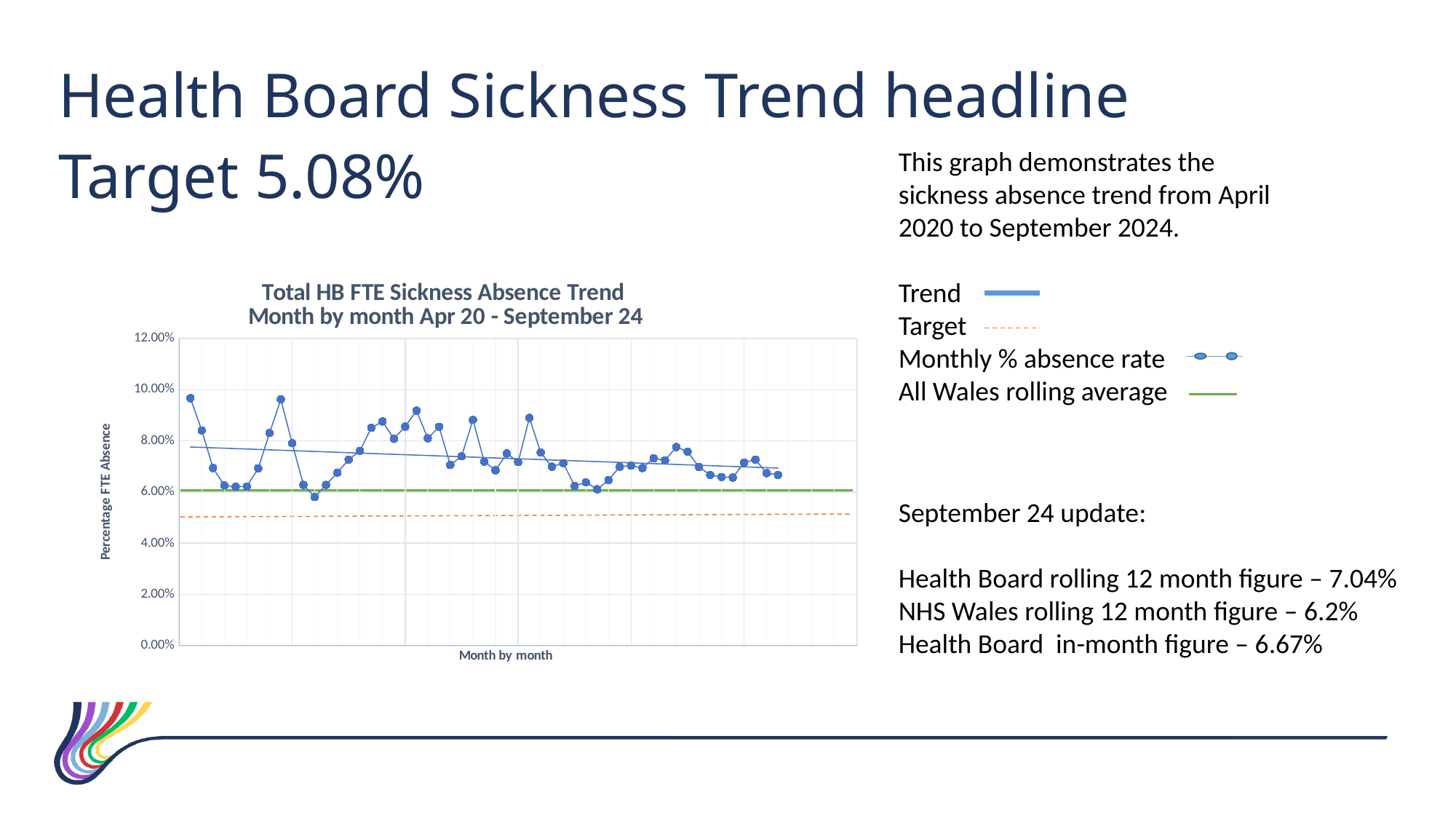
Is the Target line on the chart greater or less than 6.00%? less Does the Trend line rise or fall from left to right across the chart? Fall Is the last monthly % absence rate point on the chart greater or less than 8.00%? less What kind of chart is shown on the slide? Line chart Which is higher on the chart, the All Wales rolling average line or the Target line? All Wales rolling average How many series does the legend list for the chart? 4 What is the title of the chart? Total HB FTE Sickness Absence Trend Month by month Apr 20 - September 24 Is the first monthly % absence rate point on the chart greater or less than 8.00%? greater What is the highest value shown on the vertical axis of the chart? 12.00% What is the label on the vertical axis of the chart? Percentage FTE Absence